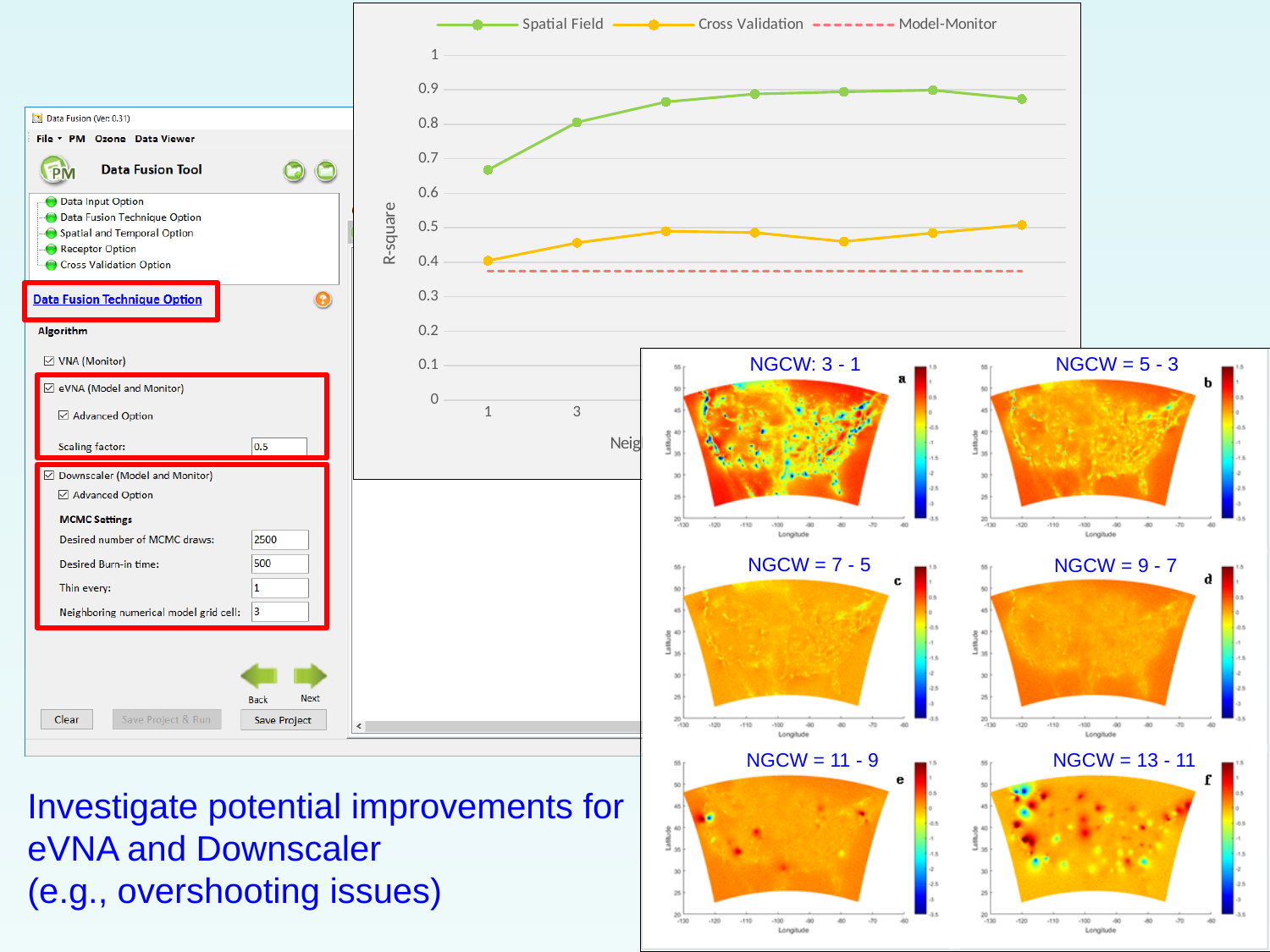
In the line chart, is the Spatial Field value at x = 3 greater or less than 0.7? greater In the line chart, does the Spatial Field series generally rise or fall from x = 1 to x = 3? rise How many series does the legend of the line chart list? 3 In the line chart, is the Model-Monitor line greater or less than 0.4? less In the line chart, which series has the lowest values across the whole x axis? Model-Monitor How many data points are plotted for the Spatial Field series in the line chart? 7 What kind of chart is shown at the top of the slide? line chart Which series in the line chart is drawn as a dashed line? Model-Monitor What is the label on the vertical axis of the line chart? R-square In the line chart, is the Spatial Field value at x = 1 greater or less than 0.6? greater In the line chart, which series has the larger value at x = 1, Spatial Field or Cross Validation? Spatial Field